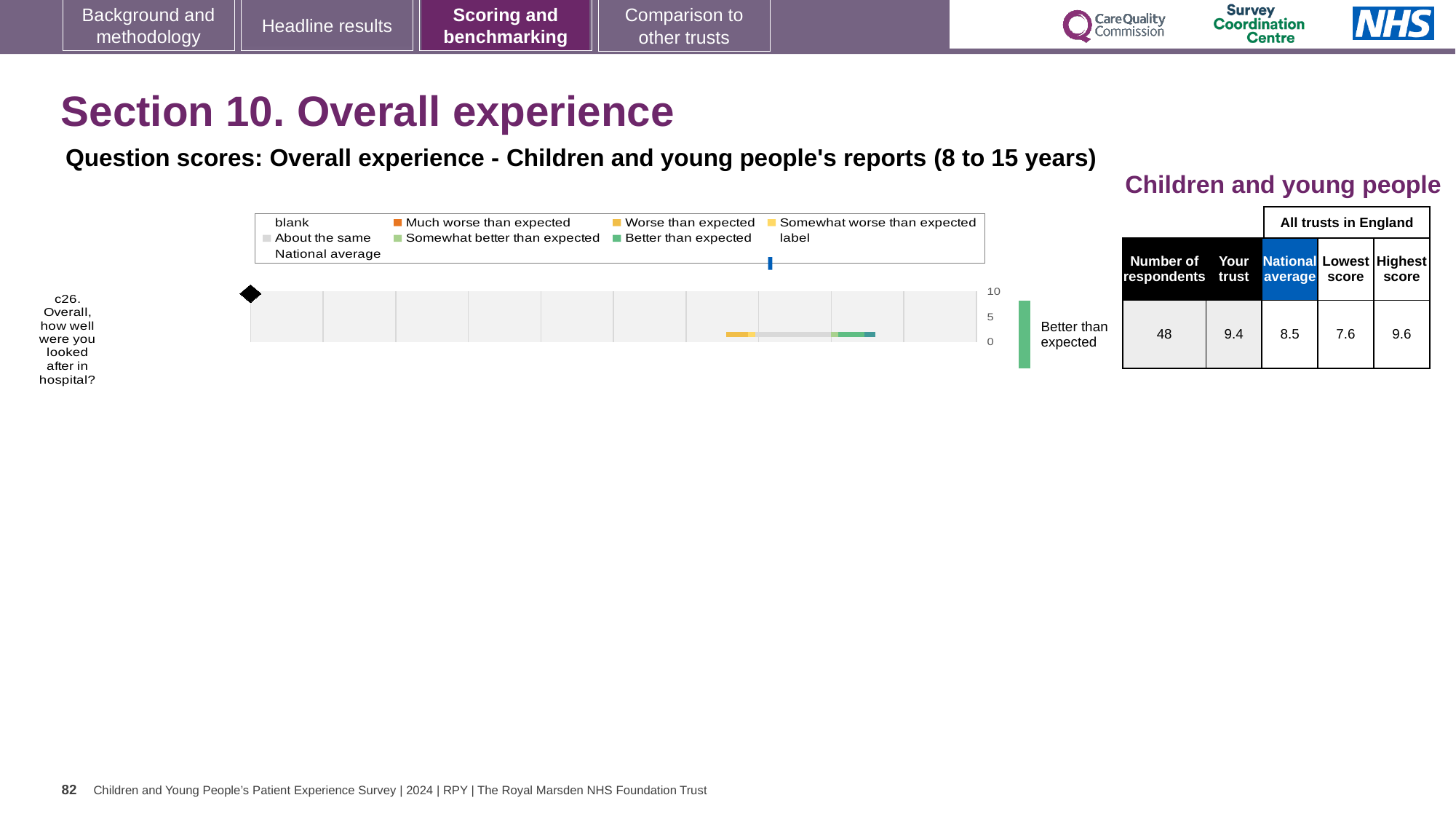
Which is larger for c26: the 'Your trust' score or the national average? Your trust What is the number of respondents for c26 in the table beside the chart? 48 Which survey question is plotted in the chart? c26. Overall, how well were you looked after in hospital? How many survey questions are plotted in the chart? 1 What is the highest score among all trusts in England for c26? 9.6 What is the lowest score among all trusts in England for c26? 7.6 By how much does the 'Your trust' score for c26 exceed the national average? 0.9 What is the national average score for c26? 8.5 What is the 'Your trust' score for c26? 9.4 What is the difference between the highest and lowest scores for c26 across all trusts in England? 2.0 What kind of chart is used to show the question score for c26? bar chart What benchmark category is shown next to the bar for c26? Better than expected